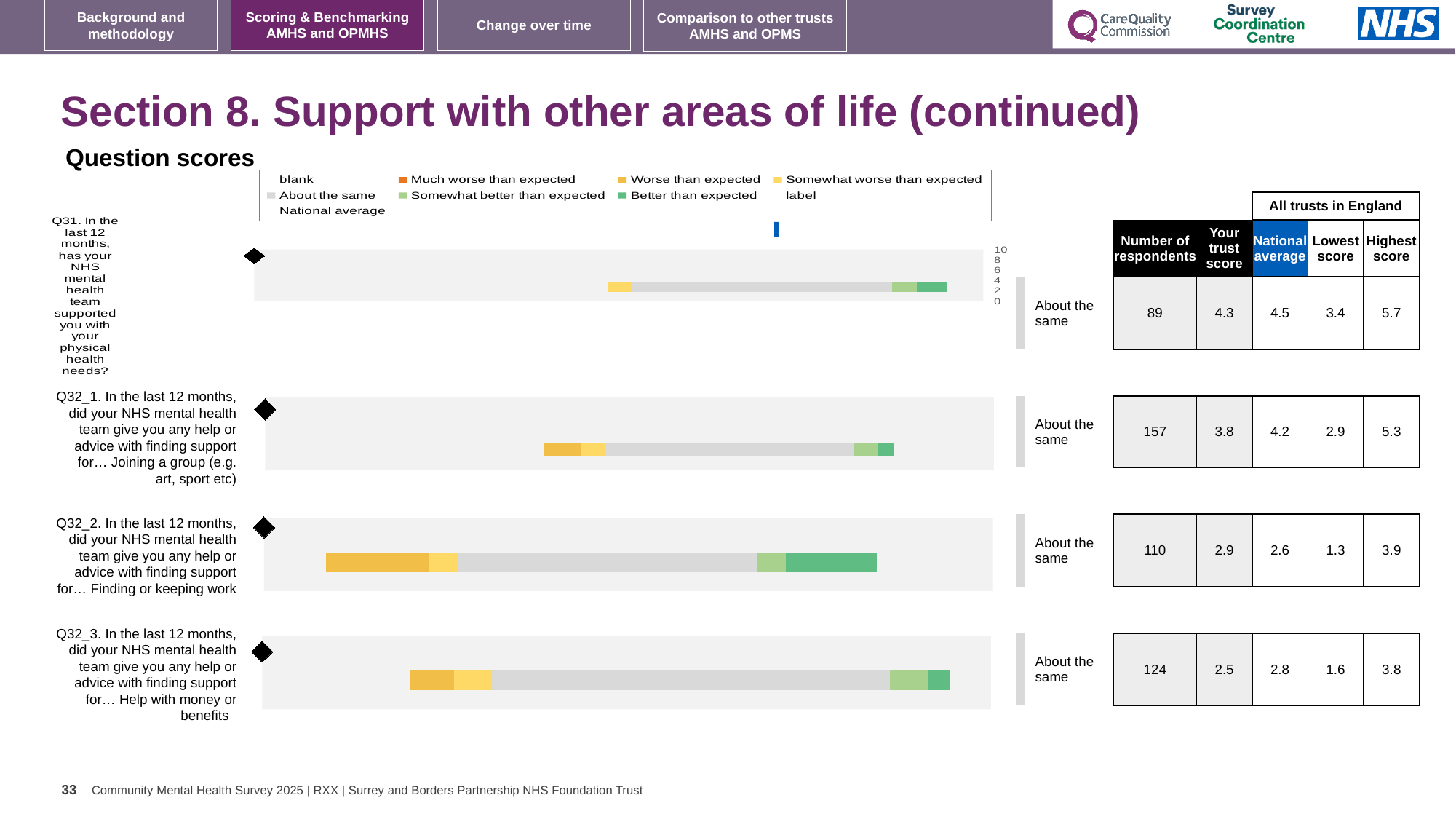
What is the 'Your trust score' value for Q31 (support with physical health needs)? 4.3 Which question has the highest number of respondents? Q32_1 (Joining a group) What is the difference between the highest score and the lowest score for Q31? 2.3 Which question has the lowest 'Your trust score'? Q32_3 (Help with money or benefits) For Q32_2 (finding or keeping work), which is larger: the trust score or the national average? the trust score (2.9) What benchmark category label is shown next to each of the four question bars? About the same How many entries does the legend of the question scores chart list? 9 What is the national average for Q32_3 (help with money or benefits)? 2.8 How many questions (bars) are plotted in the question scores chart? 4 How many respondents are recorded for Q32_1 (help with joining a group)? 157 Which legend entry is shown in orange? Much worse than expected What kind of chart is used to show the question scores on this slide? bar chart